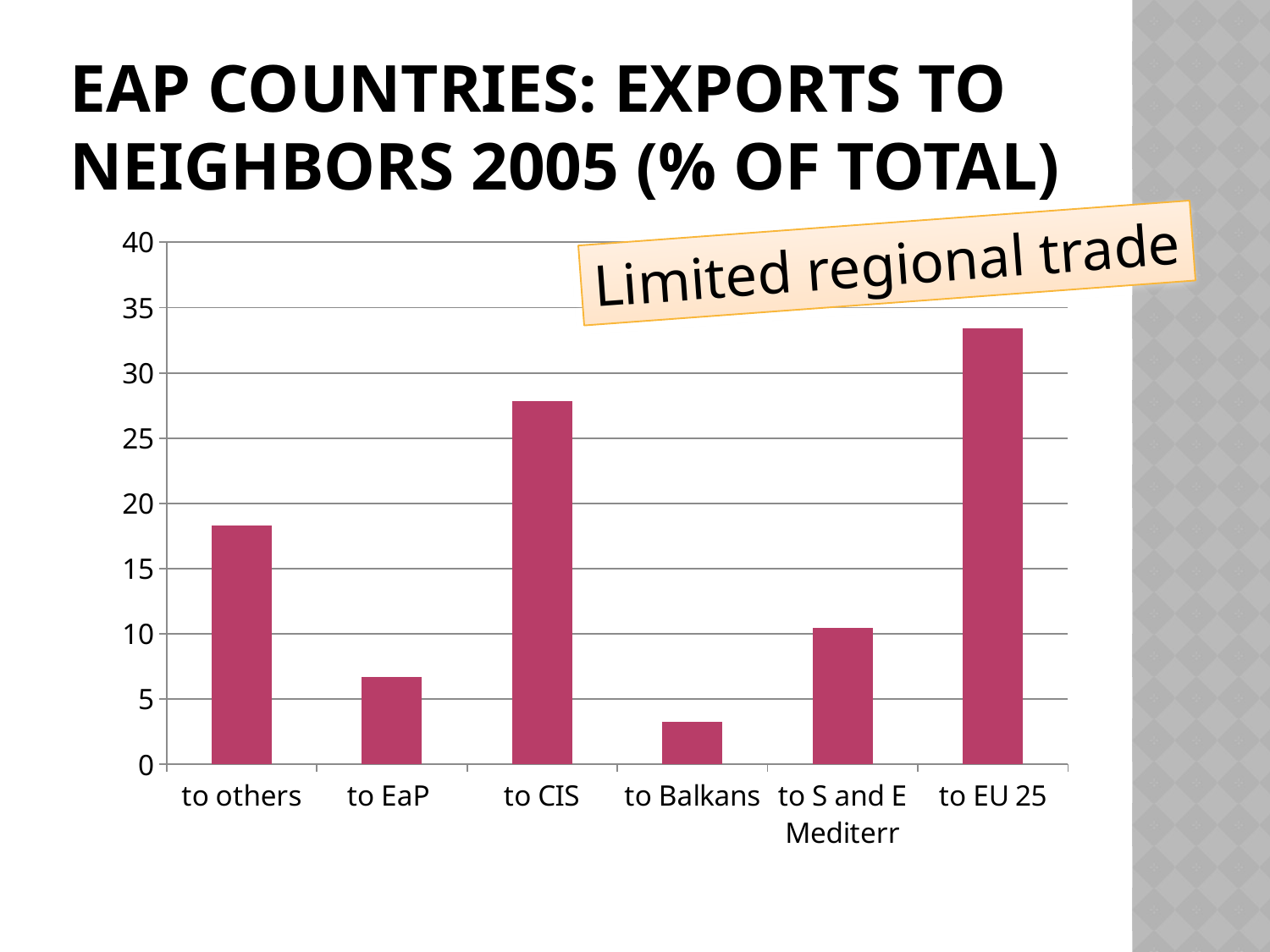
What is the title of the chart on the slide? EAP COUNTRIES: EXPORTS TO NEIGHBORS 2005 (% OF TOTAL) Is the value for 'to CIS' greater or less than 25? greater Which is larger, the value for 'to EaP' or the value for 'to Balkans'? to EaP Which is larger, the value for 'to CIS' or the value for 'to others'? to CIS Which category has the highest value in the chart? to EU 25 What kind of chart is shown on the slide? bar chart How many categories are shown on the x axis of the chart? 6 Which category has the lowest value in the chart? to Balkans Is the value for 'to EU 25' greater or less than 30? greater Is the value for 'to EaP' greater or less than 10? less